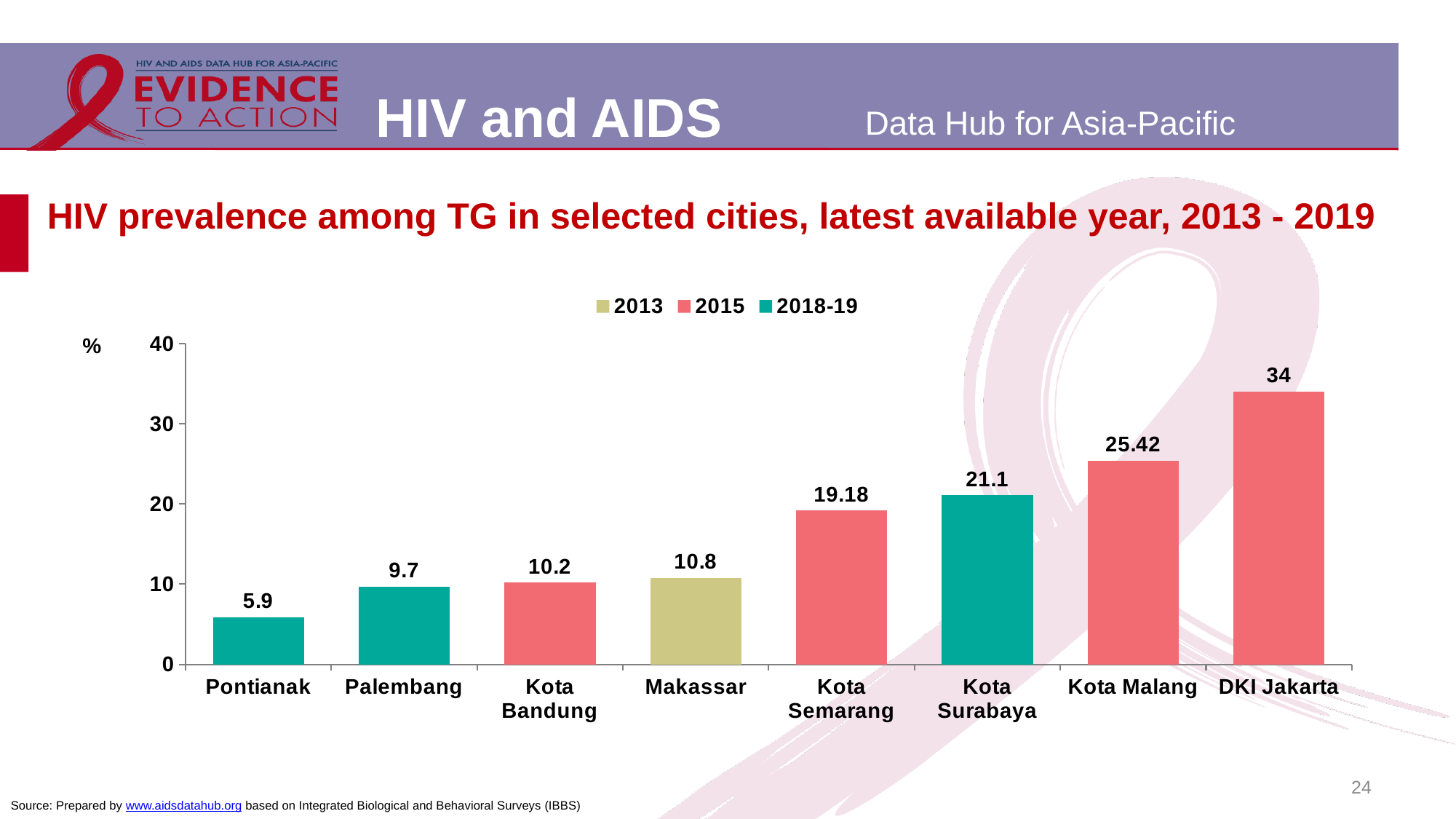
What is the HIV prevalence among TG in DKI Jakarta? 34 What is the HIV prevalence among TG in Pontianak? 5.9 Which year series does the Makassar bar belong to? 2013 How many series does the legend list? 3 What kind of chart is shown on the slide? Bar chart Which city has the highest HIV prevalence among TG? DKI Jakarta What is the HIV prevalence among TG in Kota Semarang? 19.18 How many cities are shown on the chart? 8 Which city has a higher HIV prevalence among TG, Makassar or Kota Bandung? Makassar Is the value for Kota Surabaya greater or less than 20? greater Which city has the lowest HIV prevalence among TG? Pontianak What is the difference between the HIV prevalence in Kota Malang and Kota Surabaya? 4.32